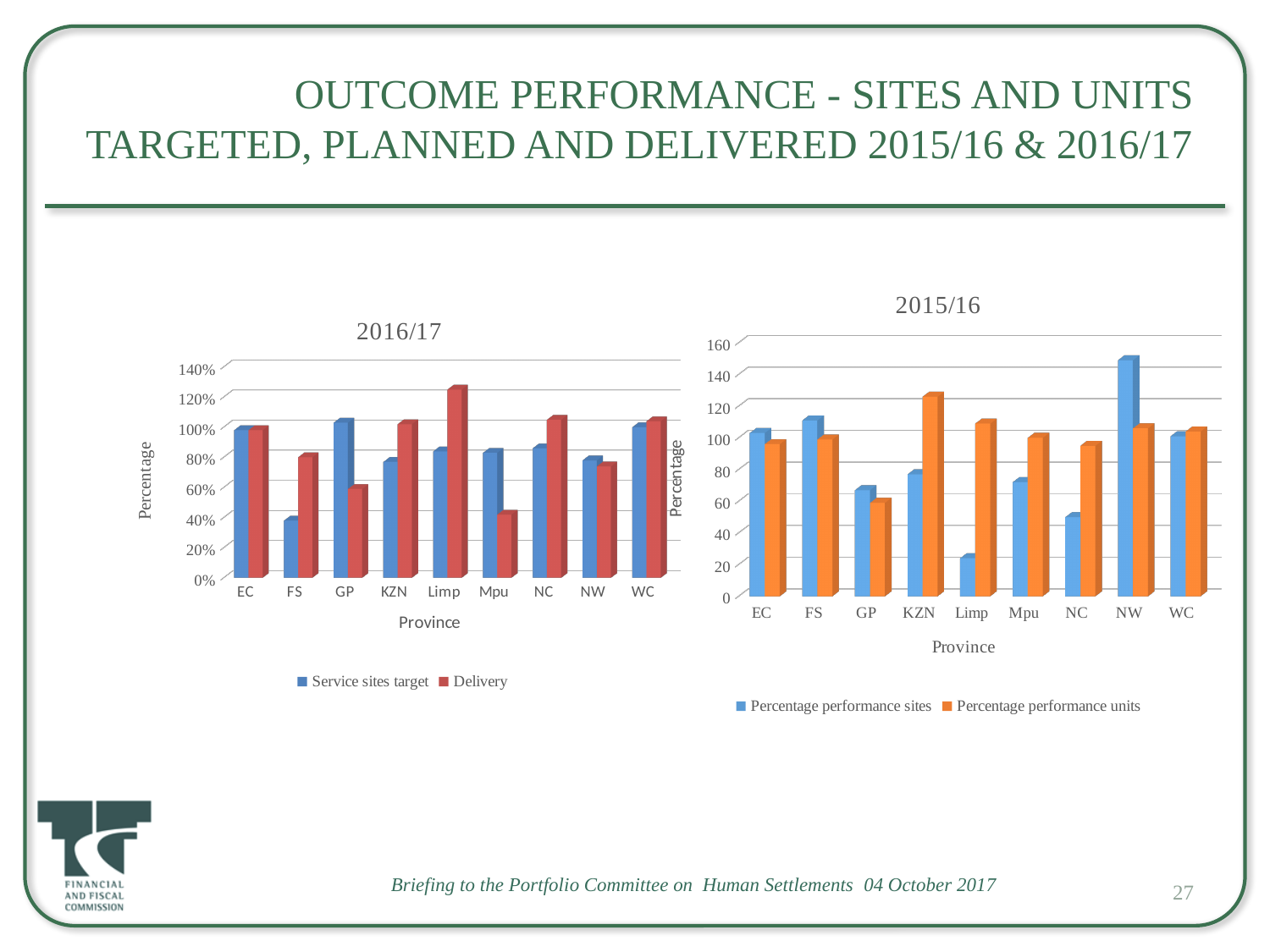
In the 2015/16 chart, which province has the highest Percentage performance sites value? NW In the 2016/17 chart, for GP, which is larger: Service sites target or Delivery? Service sites target What are the two legend entries of the 2015/16 chart? Percentage performance sites and Percentage performance units How many provinces are shown on the x axis of the 2015/16 chart? 9 In the 2015/16 chart, is the Percentage performance sites value for NW greater or less than 120? greater What kind of chart is the 2016/17 chart? bar chart In the 2015/16 chart, for KZN, which is larger: Percentage performance sites or Percentage performance units? Percentage performance units In the 2016/17 chart, which province has the lowest Service sites target value? FS In the 2016/17 chart, which province has the highest Delivery value? Limp How many series does the legend of the 2016/17 chart list? 2 In the 2015/16 chart, which province has the lowest Percentage performance sites value? Limp In the 2016/17 chart, is the Delivery value for Limp greater or less than 100%? greater